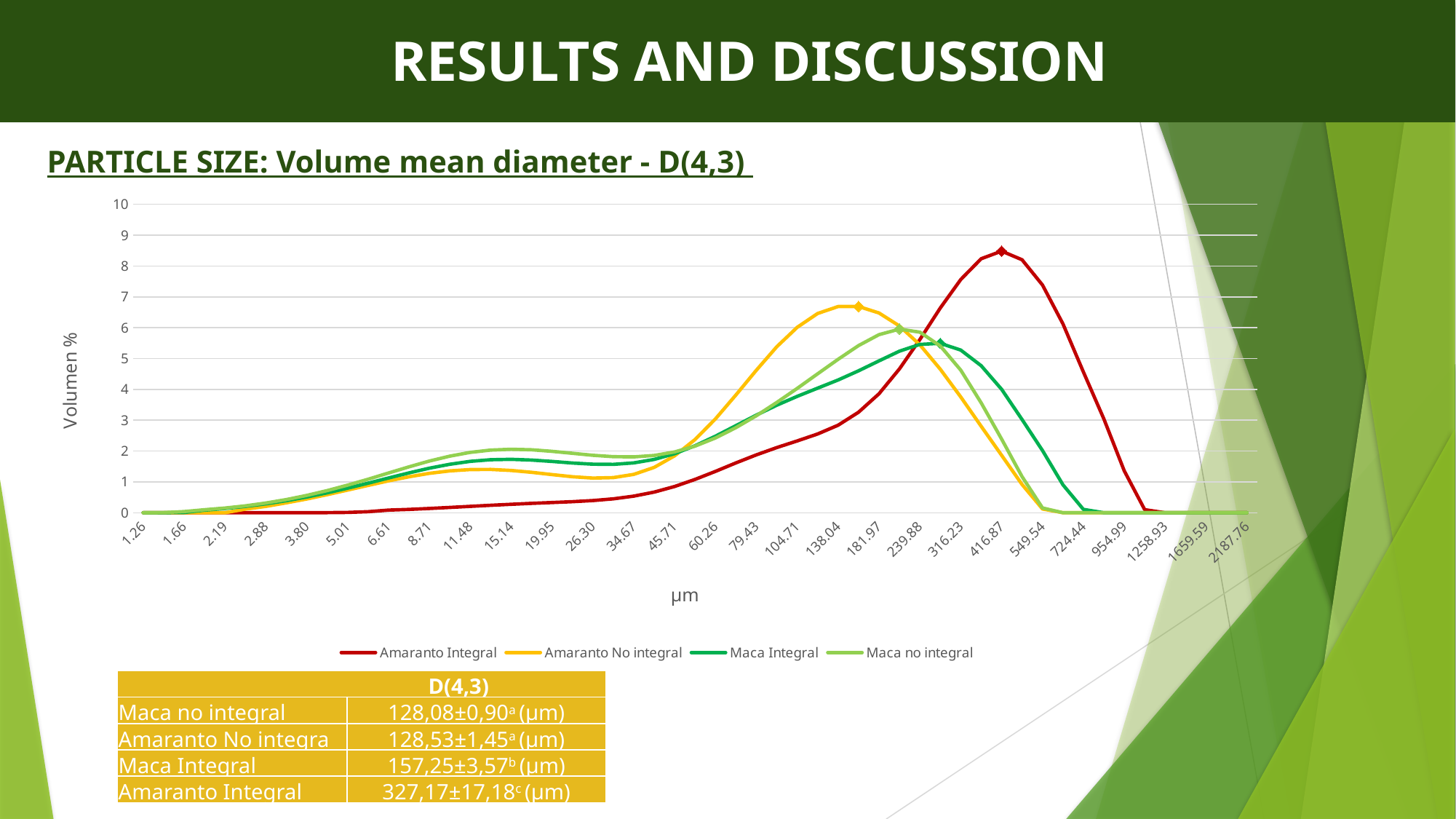
What kind of chart is shown on the slide? line chart Which is larger, the peak of Amaranto Integral or the peak of Amaranto No integral? Amaranto Integral Which series reaches the highest peak value? Amaranto Integral Is the value for Amaranto Integral at 138.04 greater or less than 4? less Is the value for Maca Integral at 316.23 greater or less than 6? less How many series does the legend list? 4 Is the peak value of the Amaranto Integral series greater or less than 8? greater Which series reaches its peak at the largest particle size on the x axis? Amaranto Integral What is the label of the y axis? Volumen % Which series is drawn in red? Amaranto Integral